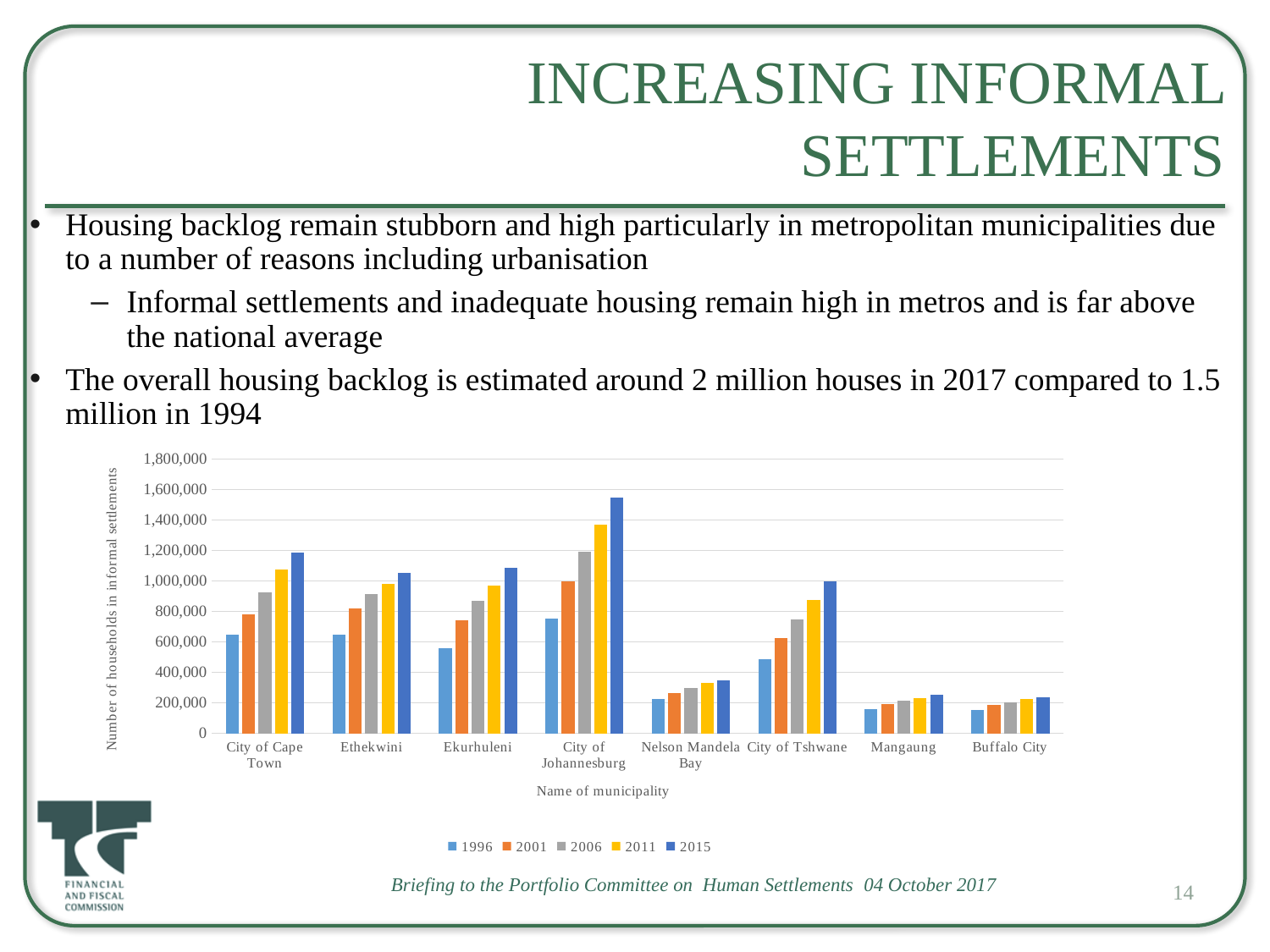
Is the 2015 value for City of Cape Town greater or less than 1,000,000? greater For City of Johannesburg, do the values rise or fall from 1996 to 2015? rise How many series does the chart legend list? 5 Is the 2015 value for City of Johannesburg greater or less than 1,400,000? greater Which municipality has the highest value for 1996? City of Johannesburg What kind of chart is shown on the slide? Bar chart Is the 1996 value for Ekurhuleni greater or less than 600,000? less Which municipality has the highest number of households in informal settlements in 2015? City of Johannesburg Which is larger: the 2011 value for City of Johannesburg or the 2015 value for City of Cape Town? 2011 value for City of Johannesburg What is the title of the chart's vertical axis? Number of households in informal settlements How many municipalities are shown on the x axis of the chart? 8